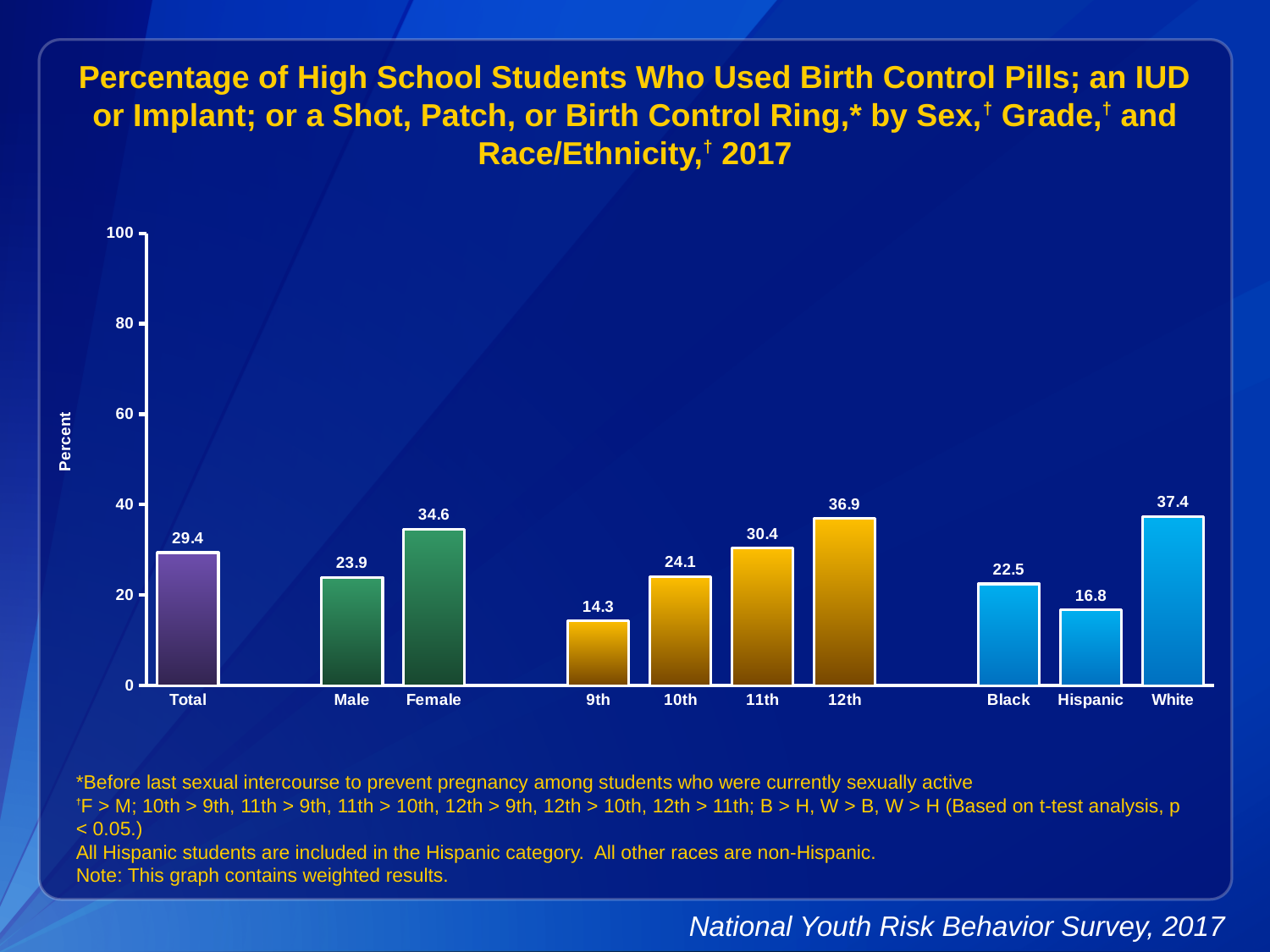
How many categories are shown on the x axis? 10 What kind of chart is shown? bar chart What is the value for Hispanic students? 16.8 What is the difference between the Female and Male values? 10.7 What is the value for Female? 34.6 Is the value for 12th grade greater or less than 40? less Do the values rise or fall from 9th grade to 12th grade? rise Which category has the lowest value? 9th What is the value for 9th grade? 14.3 Which is larger, the value for Black or the value for Hispanic? Black What is the value for Total? 29.4 Which category has the highest value? White